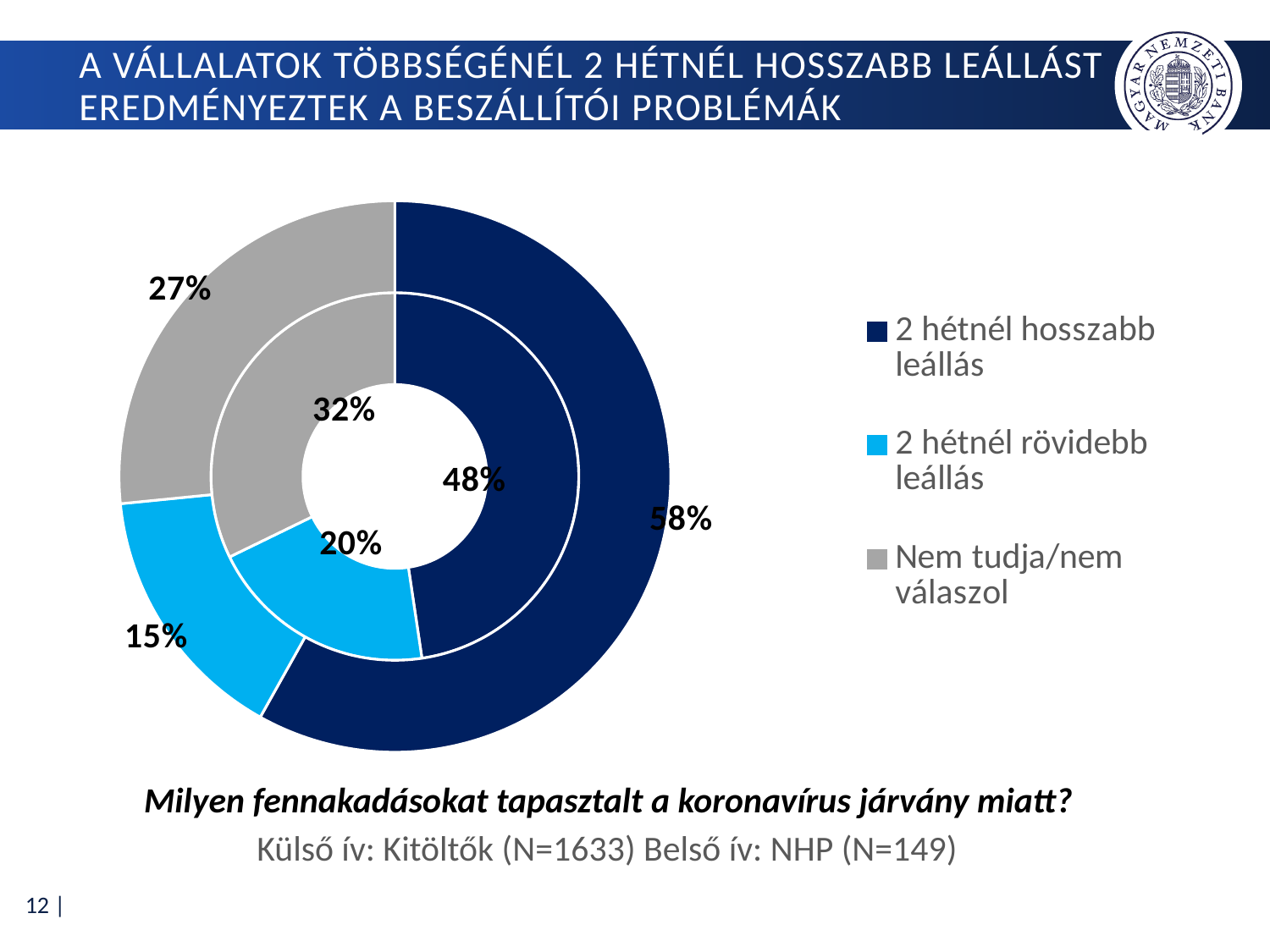
In the outer ring (Kitöltők, N=1633), what share is 'Nem tudja/nem válaszol'? 27% What is the difference between the outer-ring and inner-ring shares for '2 hétnél hosszabb leállás'? 10 percentage points In the outer ring (Kitöltők, N=1633), what share of companies reported '2 hétnél rövidebb leállás'? 15% Which colour represents 'Nem tudja/nem válaszol' in the chart? grey In the inner ring (NHP, N=149), what share of companies reported '2 hétnél rövidebb leállás'? 20% In the outer ring (Kitöltők, N=1633), what share of companies reported '2 hétnél hosszabb leállás'? 58% Which category has the smallest share in the inner ring (NHP)? 2 hétnél rövidebb leállás In the inner ring (NHP, N=149), what share of companies reported '2 hétnél hosszabb leállás'? 48% Which category has the largest share in the outer ring (Kitöltők)? 2 hétnél hosszabb leállás In the inner ring (NHP, N=149), what share is 'Nem tudja/nem válaszol'? 32% What kind of chart is shown on the slide? doughnut chart How many series does the legend list? 3